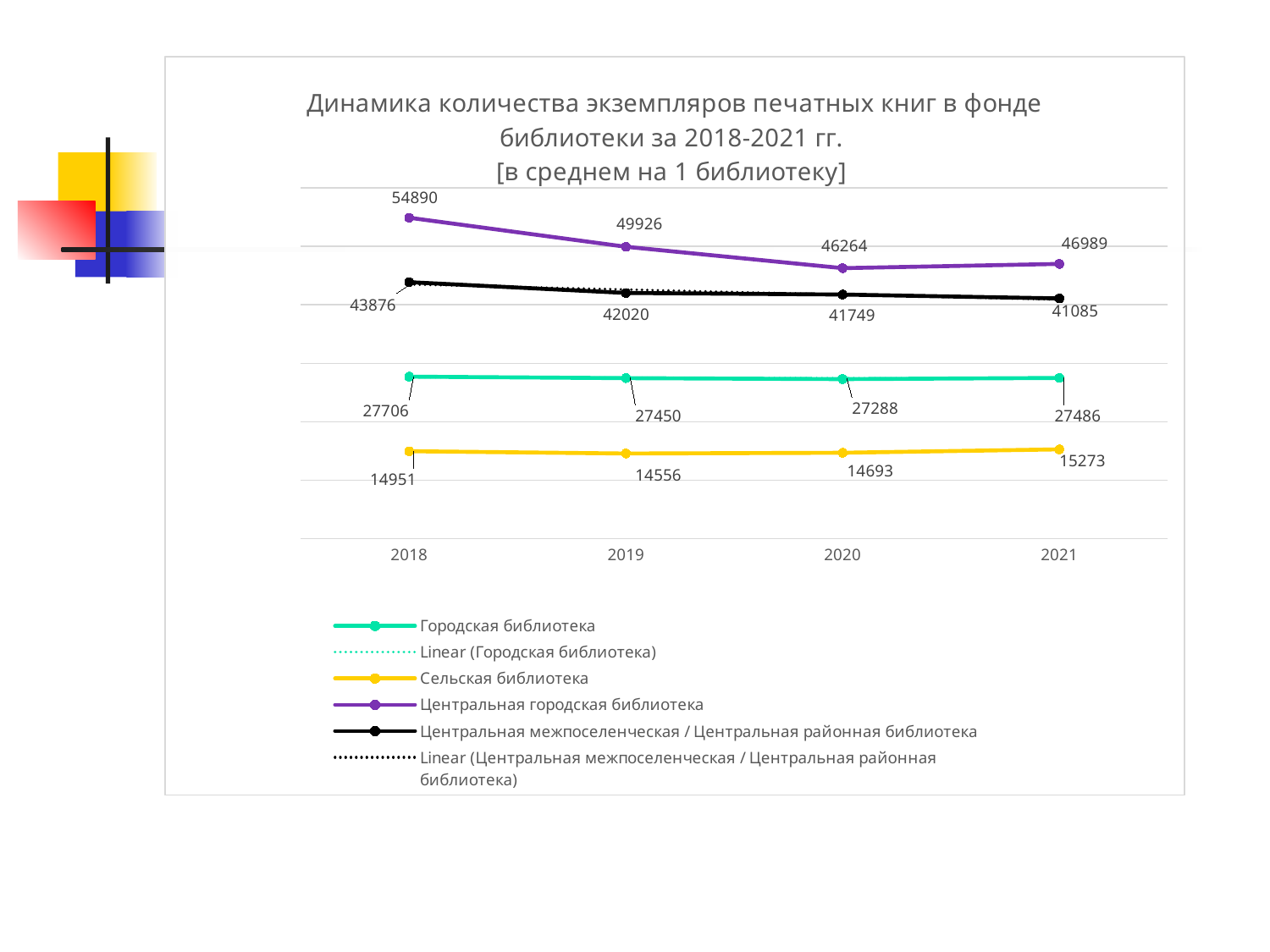
Which is larger in 2021: the value for Городская библиотека or the value for Сельская библиотека? Городская библиотека What is the value for Сельская библиотека in 2021? 15273 In which year is the value for Сельская библиотека the lowest? 2019 How many entries does the legend list? 6 What is the value for Центральная межпоселенческая / Центральная районная библиотека in 2019? 42020 In which year is the value for Центральная городская библиотека the highest? 2018 What is the value for Городская библиотека in 2020? 27288 How many years are shown on the x axis? 4 What is the difference between the 2018 and 2021 values for Центральная городская библиотека? 7901 What type of chart is shown on the slide? line chart Does the value for Центральная межпоселенческая / Центральная районная библиотека rise or fall from 2018 to 2021? fall What is the value for Центральная городская библиотека in 2018? 54890